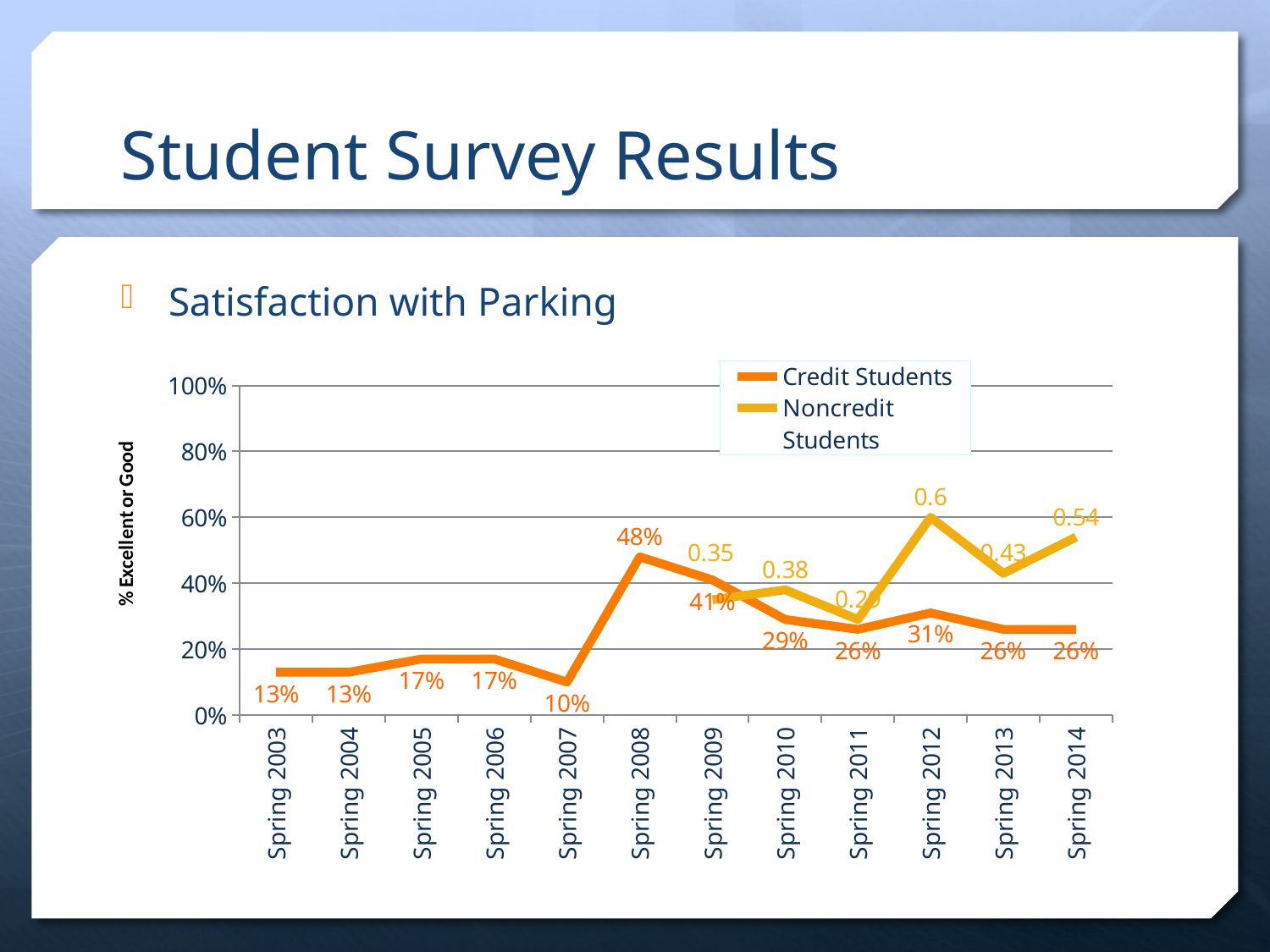
What is the value for Credit Students in Spring 2007? 10% Which is larger in Spring 2013: the Credit Students value or the Noncredit Students value? Noncredit Students In which period is the Credit Students value lowest? Spring 2007 How many series does the legend list? 2 What is the value for Noncredit Students in Spring 2012? 0.6 What is the value for Credit Students in Spring 2008? 48% What is the value for Noncredit Students in Spring 2014? 0.54 In which period is the Credit Students value highest? Spring 2008 What is the label of the vertical axis? % Excellent or Good What is the difference between the Credit Students values for Spring 2008 and Spring 2009? 7% What type of chart is shown on the slide? line chart How many periods are shown on the x axis? 12